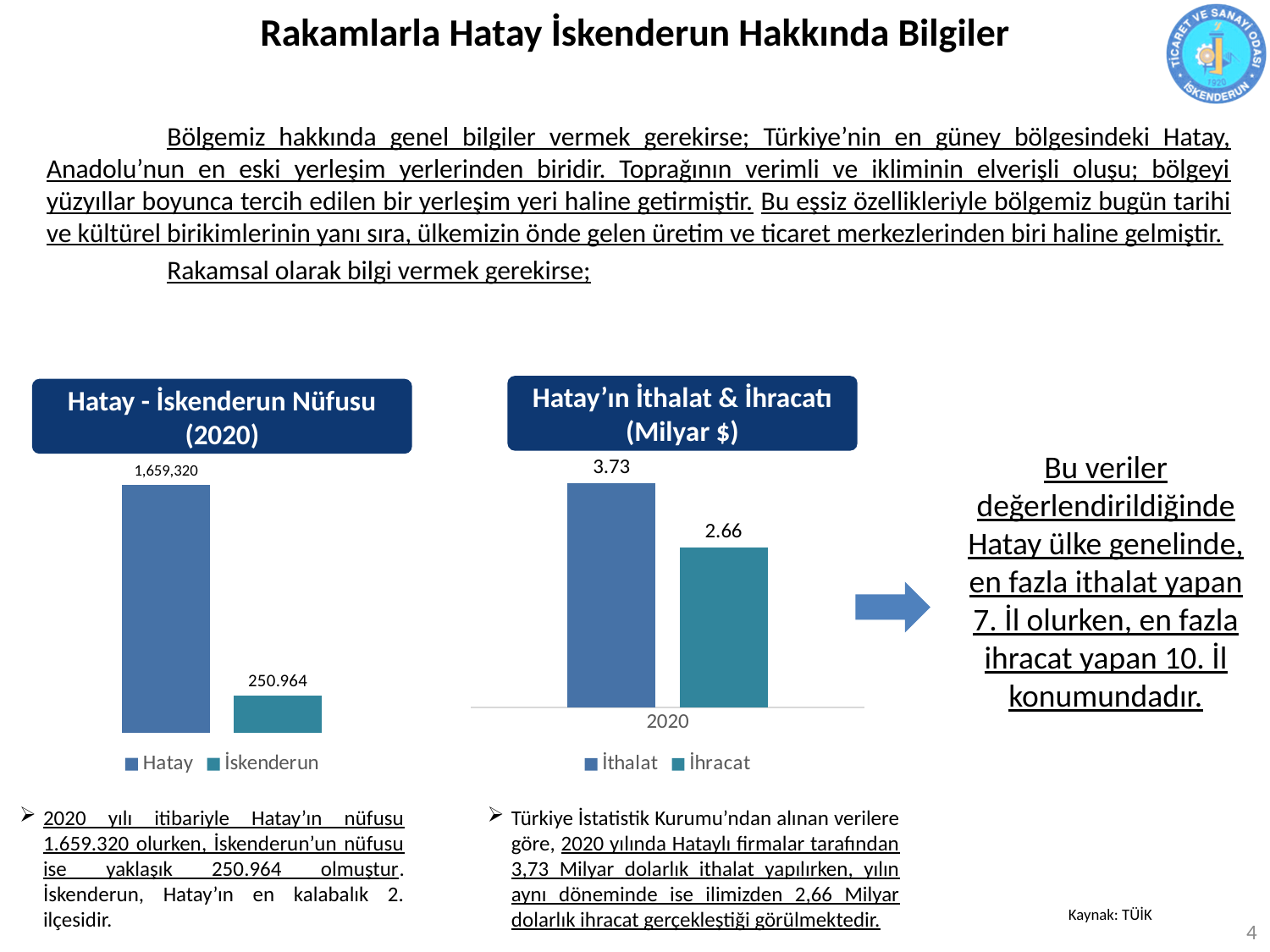
In the 'Hatay - İskenderun Nüfusu (2020)' chart, which series has the larger value, Hatay or İskenderun? Hatay What year is shown on the x axis of the 'Hatay'ın İthalat & İhracatı (Milyar $)' chart? 2020 In the 'Hatay'ın İthalat & İhracatı (Milyar $)' chart, what is the difference between İthalat and İhracat? 1.07 How many series does the legend of the 'Hatay'ın İthalat & İhracatı (Milyar $)' chart list? 2 In the 'Hatay'ın İthalat & İhracatı (Milyar $)' chart, which is larger, İthalat or İhracat? İthalat How many series does the legend of the 'Hatay - İskenderun Nüfusu (2020)' chart list? 2 In the 'Hatay'ın İthalat & İhracatı (Milyar $)' chart, what is the value for İhracat? 2.66 What kind of chart is the 'Hatay'ın İthalat & İhracatı (Milyar $)' chart? bar chart In the 'Hatay - İskenderun Nüfusu (2020)' chart, what is the value for İskenderun? 250.964 What kind of chart is the 'Hatay - İskenderun Nüfusu (2020)' chart? bar chart In the 'Hatay - İskenderun Nüfusu (2020)' chart, what is the value for Hatay? 1,659,320 In the 'Hatay'ın İthalat & İhracatı (Milyar $)' chart, what is the value for İthalat? 3.73